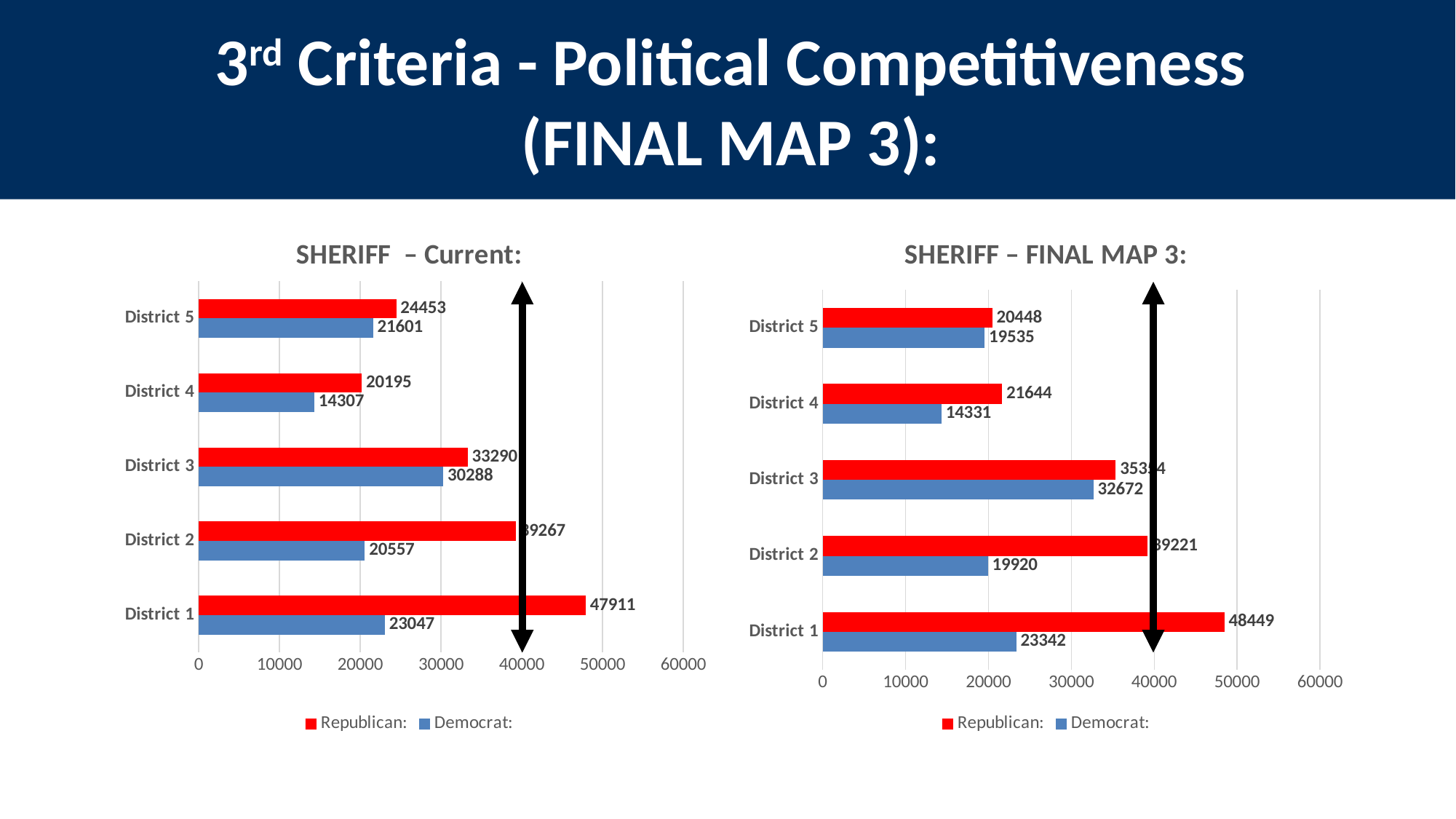
What type of chart is the SHERIFF – Current chart? Bar chart In the SHERIFF – Current chart, which is larger for District 3, the Republican value or the Democrat value? Republican In the SHERIFF – Current chart, which district has the highest Republican value? District 1 How many districts are shown in the SHERIFF – FINAL MAP 3 chart? 5 In the SHERIFF – Current chart, what is the Democrat value for District 4? 14307 In the SHERIFF – FINAL MAP 3 chart, what is the Republican value for District 5? 20448 In the SHERIFF – FINAL MAP 3 chart, what is the difference between the Republican and Democrat values for District 4? 7313 How many series does the legend of the SHERIFF – Current chart list? 2 In the SHERIFF – Current chart, what is the Republican value for District 1? 47911 In the SHERIFF – FINAL MAP 3 chart, what is the Democrat value for District 1? 23342 In the SHERIFF – FINAL MAP 3 chart, which district has the lowest Democrat value? District 4 In the SHERIFF – Current chart, what is the difference between the Republican and Democrat values for District 5? 2852